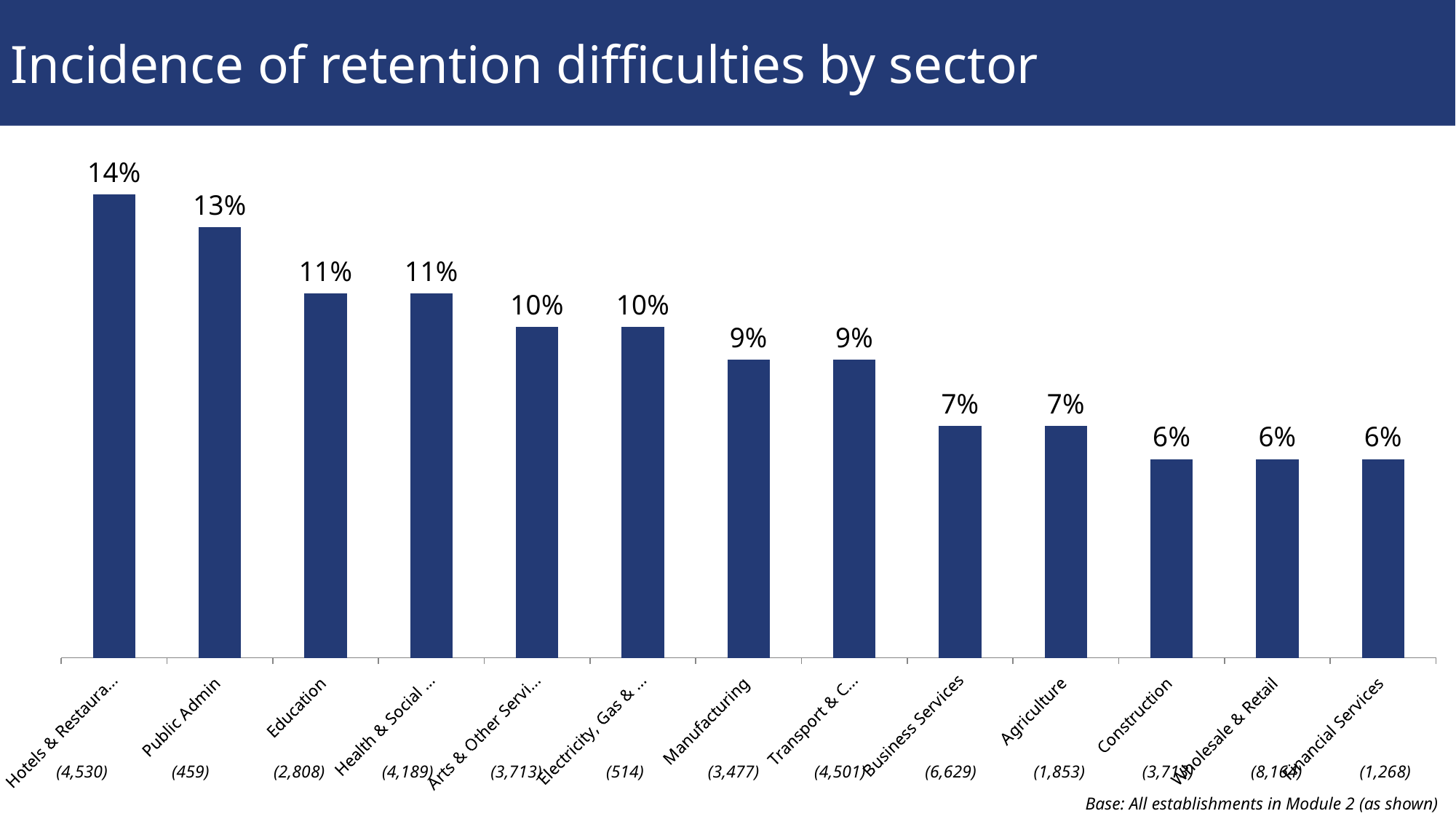
What is the value for Wholesale & Retail? 6% What is the value for Business Services? 7% What is the highest value shown on the chart? 14% Do the values rise or fall from left to right across the chart? Fall What is the value for Education? 11% What is the lowest value shown on the chart? 6% What kind of chart is shown on the slide? Bar chart What is the value for Public Admin? 13% What is the value for Manufacturing? 9% Which has a larger value, Education or Construction? Education How many sectors are shown on the chart? 13 What is the difference between the values for Public Admin and Agriculture? 6%